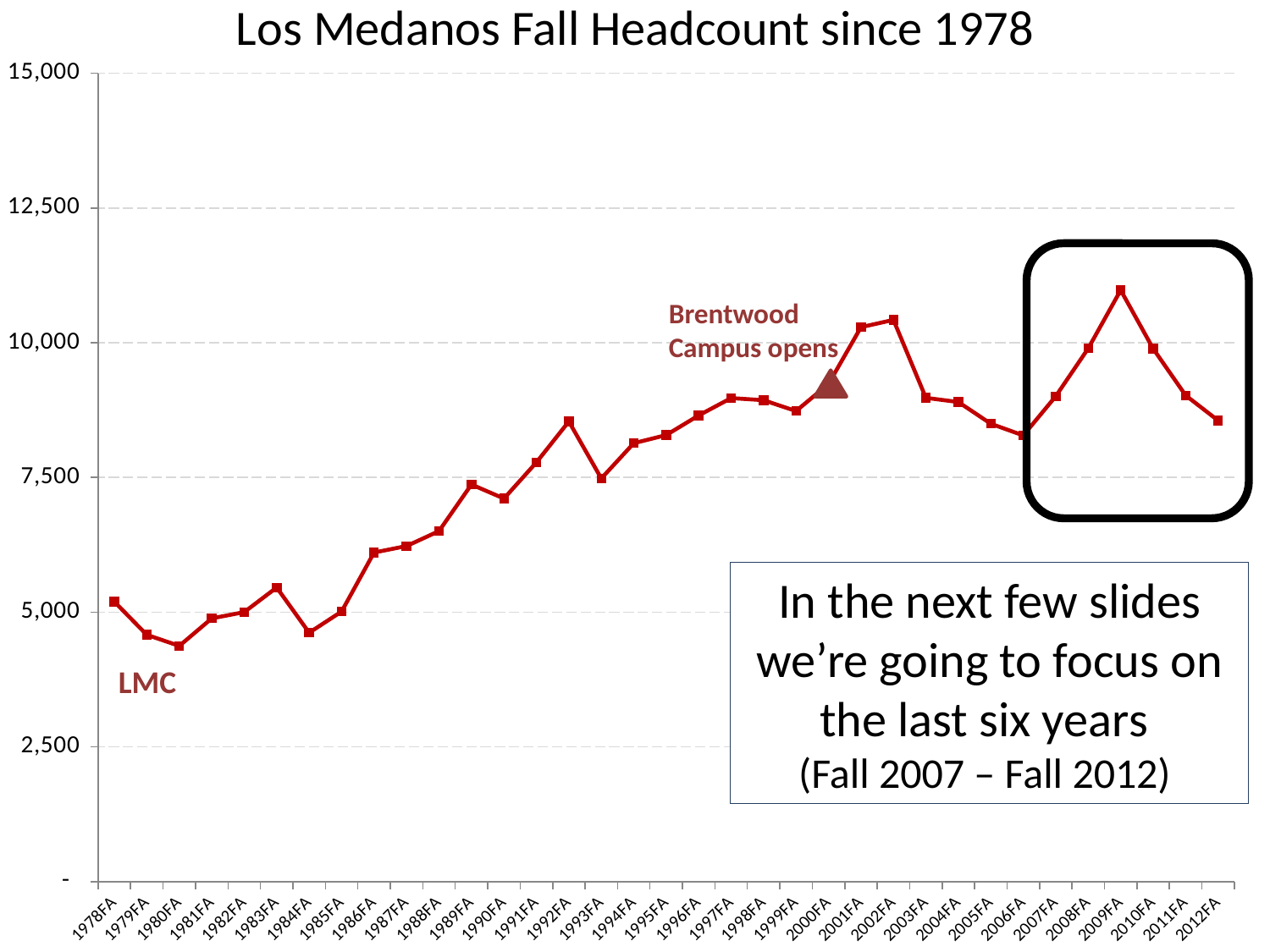
Is the headcount for 1992FA greater or less than 7,500? greater Which fall term has the lowest headcount? 1980FA How many fall terms are plotted on the x axis? 35 Which has the larger headcount, 2009FA or 2002FA? 2009FA Is the headcount for 1984FA greater or less than 5,000? less Which fall term has the highest headcount? 2009FA Is the headcount for 2012FA greater or less than 10,000? less What is the title of the chart? Los Medanos Fall Headcount since 1978 At which fall term does the annotation say the Brentwood Campus opens? 2000FA What kind of chart is shown on the slide? line chart Does the headcount rise or fall from 2009FA to 2012FA? fall